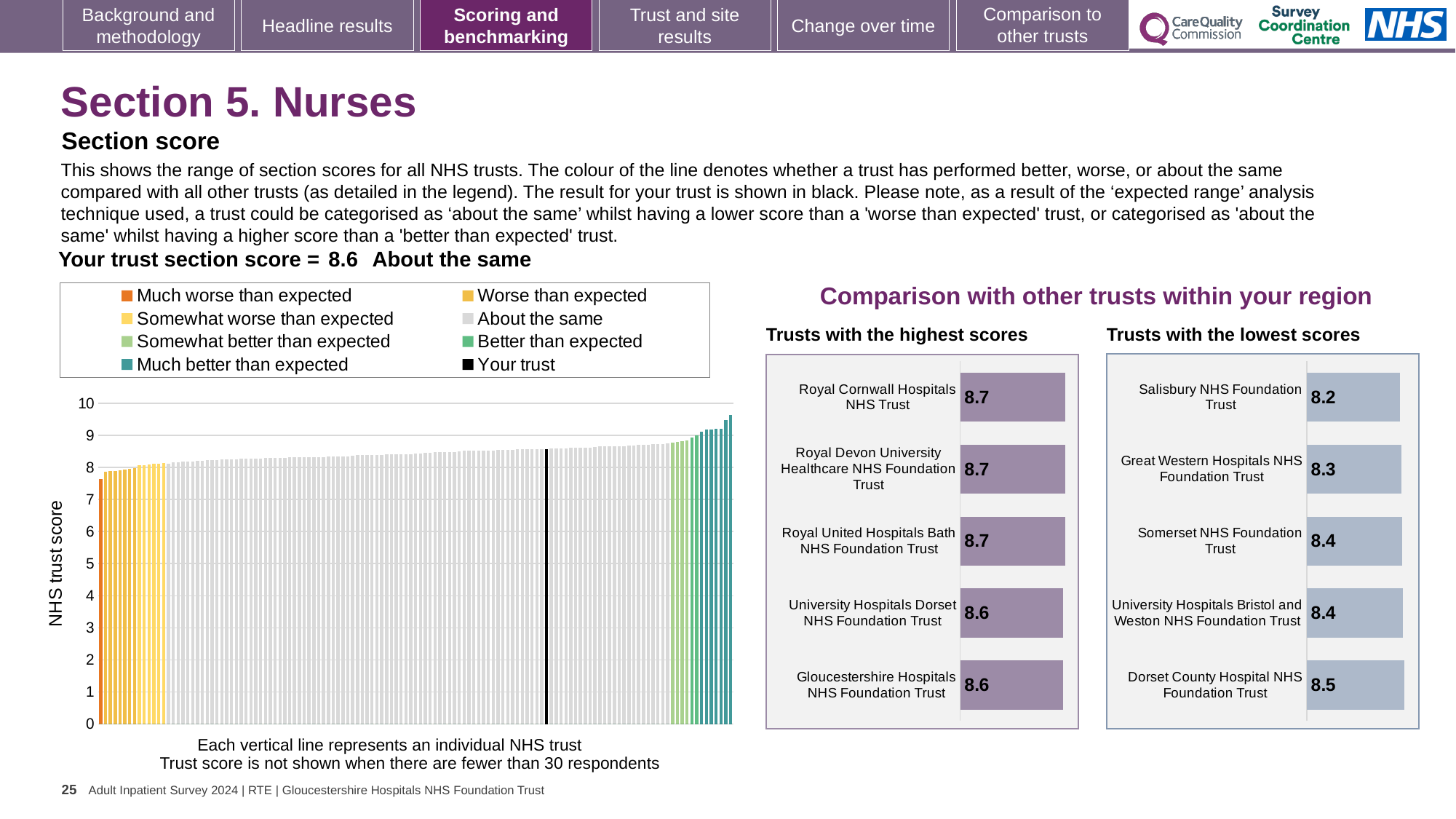
How many trusts are shown in the 'Trusts with the highest scores' chart? 5 In the 'Trusts with the lowest scores' chart, what is the difference between the scores of Dorset County Hospital NHS Foundation Trust and Salisbury NHS Foundation Trust? 0.3 In the 'Trusts with the highest scores' chart, what is the difference between the scores of Royal Cornwall Hospitals NHS Trust and University Hospitals Dorset NHS Foundation Trust? 0.1 In the 'Trusts with the lowest scores' chart, which has the higher score: Great Western Hospitals NHS Foundation Trust or Somerset NHS Foundation Trust? Somerset NHS Foundation Trust In the large NHS trust score chart on the left, do the values rise or fall from left to right? Rise In the 'Trusts with the lowest scores' chart, what is the score for Dorset County Hospital NHS Foundation Trust? 8.5 In the 'Trusts with the lowest scores' chart, what is the score for Salisbury NHS Foundation Trust? 8.2 In the 'Trusts with the highest scores' chart, what is the score for Royal Cornwall Hospitals NHS Trust? 8.7 How many entries does the legend of the large NHS trust score chart on the left list? 8 In the 'Trusts with the lowest scores' chart, which trust has the lowest score? Salisbury NHS Foundation Trust In the 'Trusts with the highest scores' chart, what is the score for Gloucestershire Hospitals NHS Foundation Trust? 8.6 What kind of chart is the 'Trusts with the lowest scores' chart? Bar chart